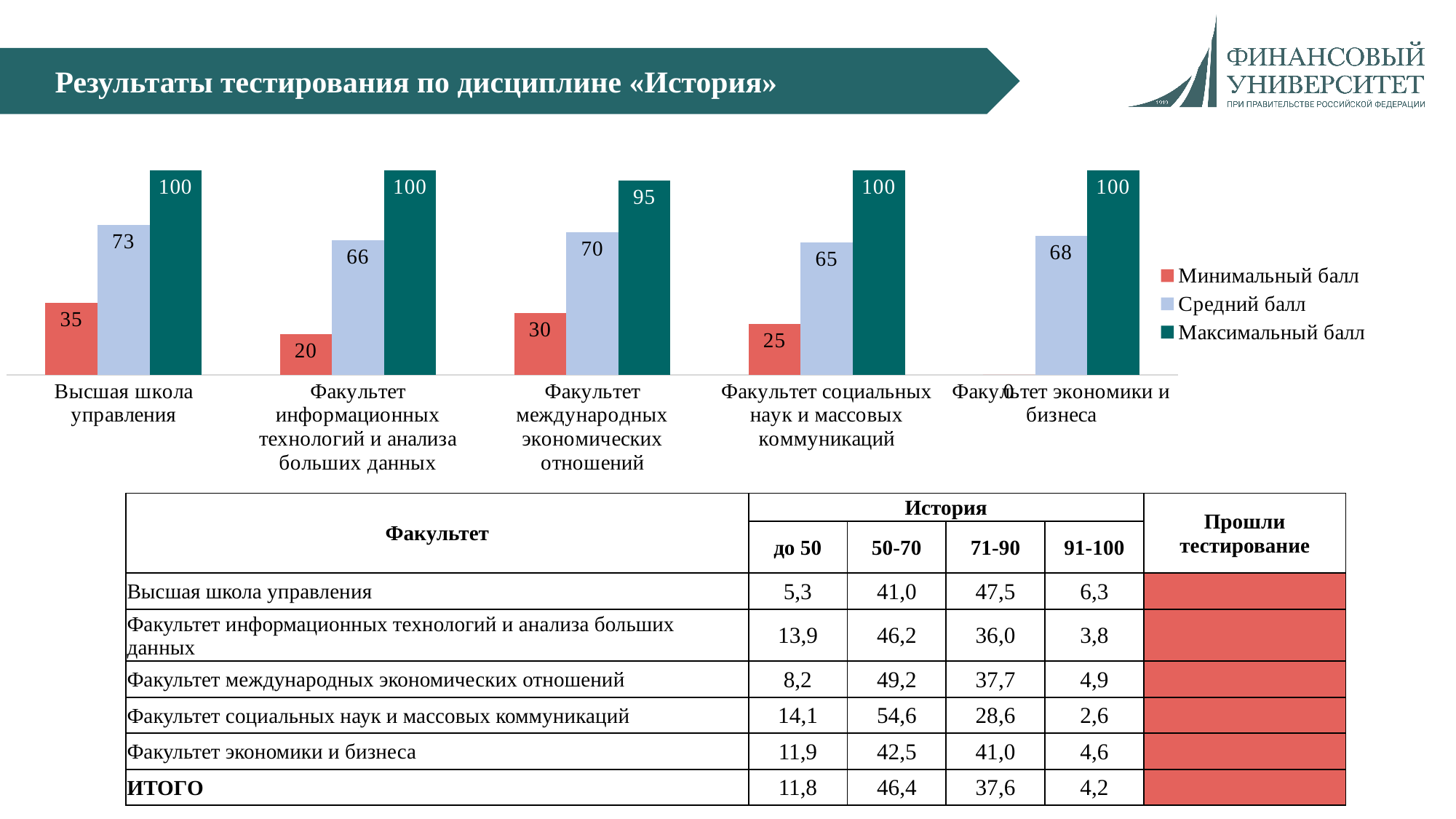
Which faculty has the lowest Средний балл? Факультет социальных наук и массовых коммуникаций How many faculties are shown on the chart? 5 What is the Максимальный балл for Факультет международных экономических отношений? 95 What is the Минимальный балл for Факультет социальных наук и массовых коммуникаций? 25 What is the Средний балл for Высшая школа управления? 73 Which is larger: the Минимальный балл for Высшая школа управления or for Факультет международных экономических отношений? Высшая школа управления How many series does the chart legend list? 3 What type of chart is shown on the slide? bar chart Which faculty has the lowest Максимальный балл? Факультет международных экономических отношений What is the Минимальный балл for Факультет информационных технологий и анализа больших данных? 20 Which faculty has the highest Средний балл? Высшая школа управления What is the difference between the Средний балл of Высшая школа управления and that of Факультет социальных наук и массовых коммуникаций? 8